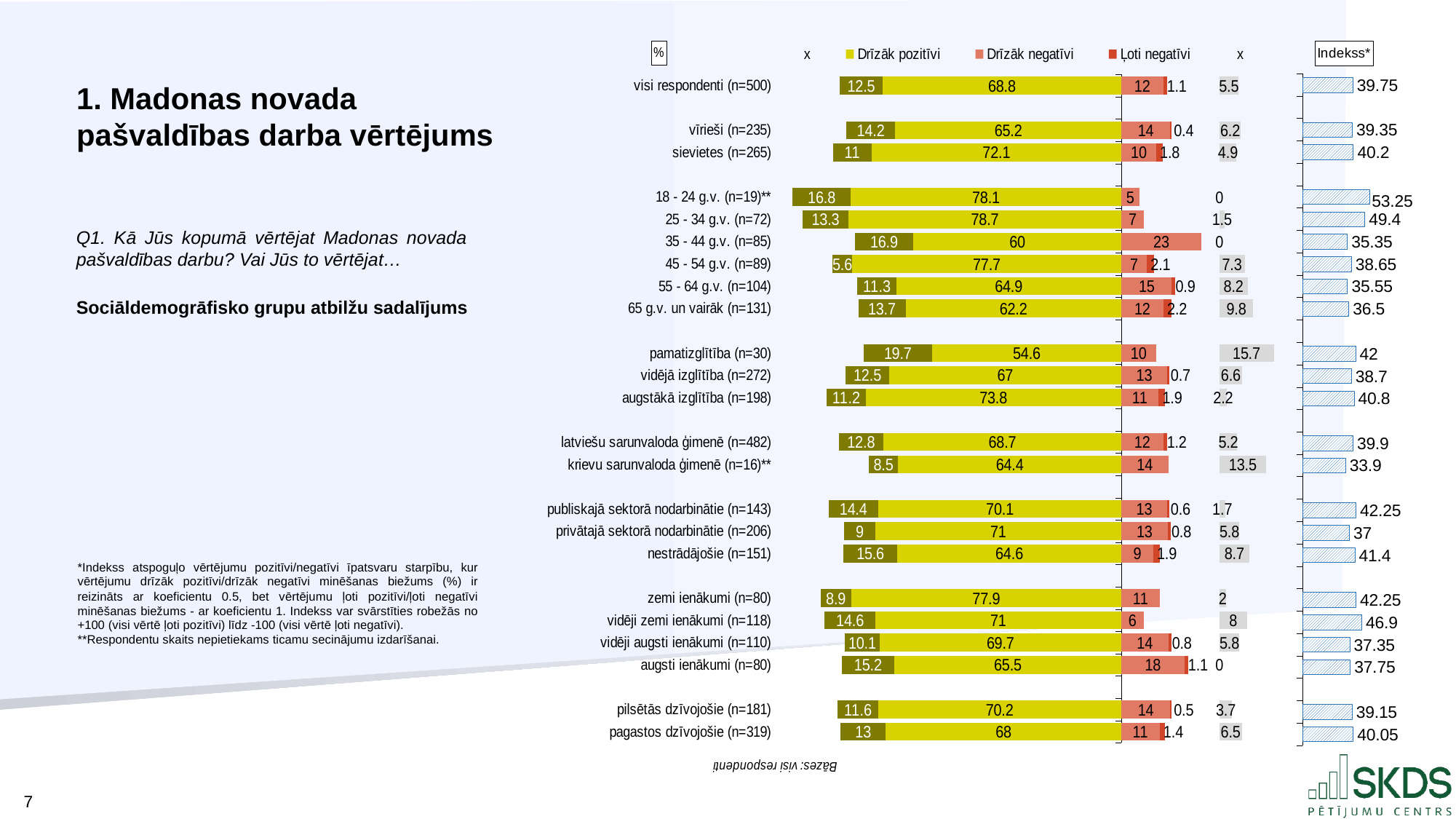
What is the 'Drīzāk pozitīvi' value for 'visi respondenti (n=500)'? 68.8 What is the difference between the 'Drīzāk pozitīvi' values for 'sievietes (n=265)' and 'vīrieši (n=235)'? 6.9 What is the Indekss* value for 'pagastos dzīvojošie (n=319)'? 40.05 Which has the larger 'Drīzāk pozitīvi' value: '25 - 34 g.v. (n=72)' or '45 - 54 g.v. (n=89)'? 25 - 34 g.v. (n=72) Which group has the highest 'Drīzāk pozitīvi' value? 25 - 34 g.v. (n=72) Which group has the lowest Indekss* value? krievu sarunvaloda ģimenē (n=16)** What is the Indekss* value for '18 - 24 g.v. (n=19)**'? 53.25 What kind of chart is used to show the answer distribution? Stacked bar chart Which group has the highest Indekss* value? 18 - 24 g.v. (n=19)** What is the difference between the Indekss* values for 'sievietes (n=265)' and 'vīrieši (n=235)'? 0.85 What is the 'Drīzāk pozitīvi' value for 'pamatizglītība (n=30)'? 54.6 What is the 'Drīzāk negatīvi' value for '35 - 44 g.v. (n=85)'? 23